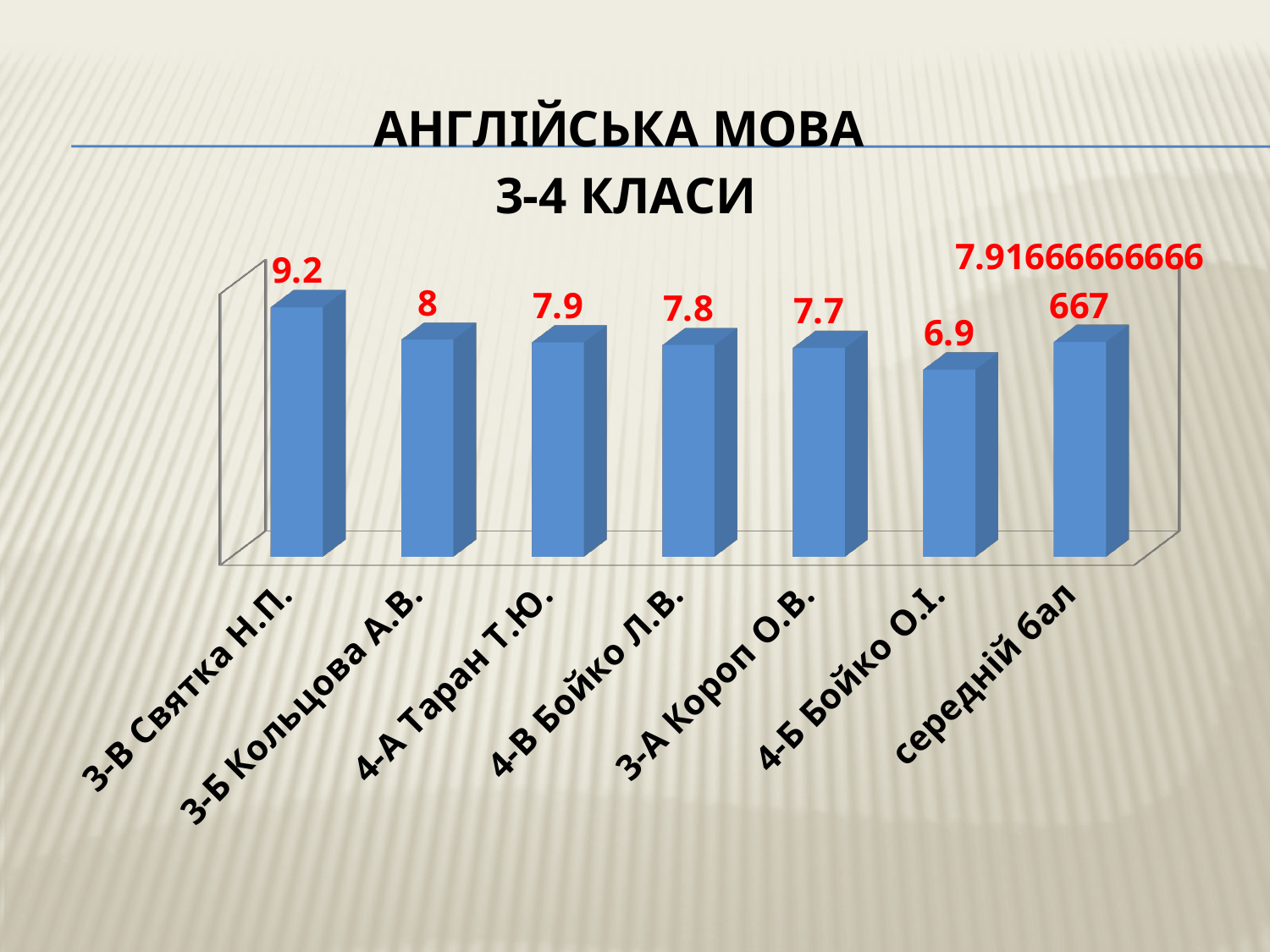
What is the value for 4-Б Бойко О.І.? 6.9 What is the value for 3-В Святка Н.П.? 9.2 What is the difference between the values for 3-В Святка Н.П. and 4-Б Бойко О.І.? 2.3 Which category has the highest value? 3-В Святка Н.П. What is the value shown for середній бал? 7.91666666666667 What is the title of the slide? АНГЛІЙСЬКА МОВА 3-4 КЛАСИ Which category has the lowest value? 4-Б Бойко О.І. Which is larger, the value for 4-А Таран Т.Ю. or the value for 4-Б Бойко О.І.? 4-А Таран Т.Ю. What kind of chart is shown on the slide? Bar chart How many bars are shown in the chart? 7 What is the value for 3-А Короп О.В.? 7.7 What is the difference between the values for 3-Б Кольцова А.В. and 3-А Короп О.В.? 0.3